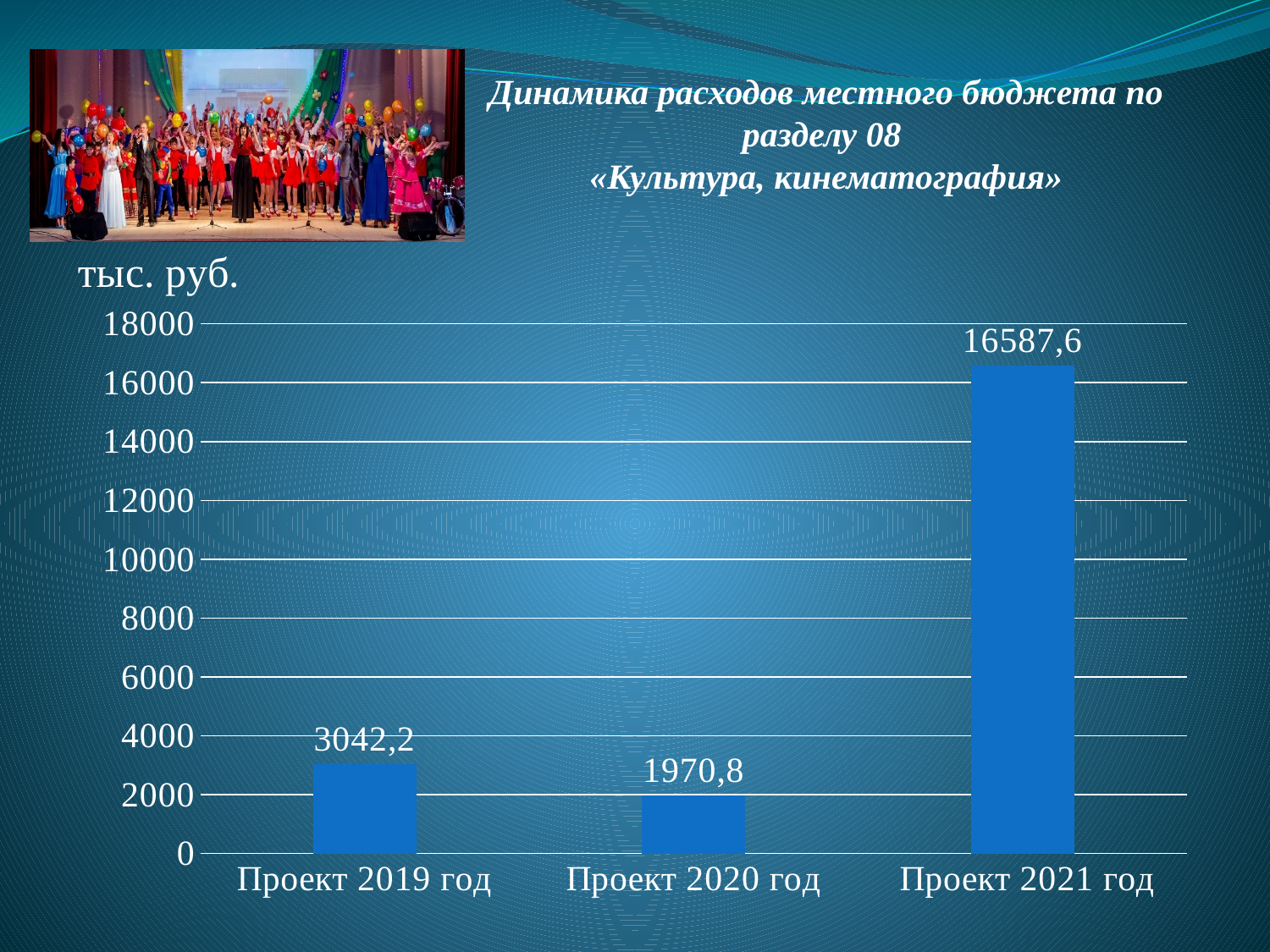
How many categories are shown on the x axis? 3 What is the value for Проект 2020 год? 1970,8 Which category has the lowest value? Проект 2020 год What unit is indicated above the vertical axis of the chart? тыс. руб. What is the value for Проект 2021 год? 16587,6 What is the difference between the values for Проект 2021 год and Проект 2019 год? 13545,4 Is the value for Проект 2021 год greater or less than 16000? greater What is the difference between the values for Проект 2019 год and Проект 2020 год? 1071,4 Which is larger, the value for Проект 2019 год or Проект 2020 год? Проект 2019 год Which category has the highest value? Проект 2021 год What kind of chart is shown on the slide? bar chart What is the value for Проект 2019 год? 3042,2